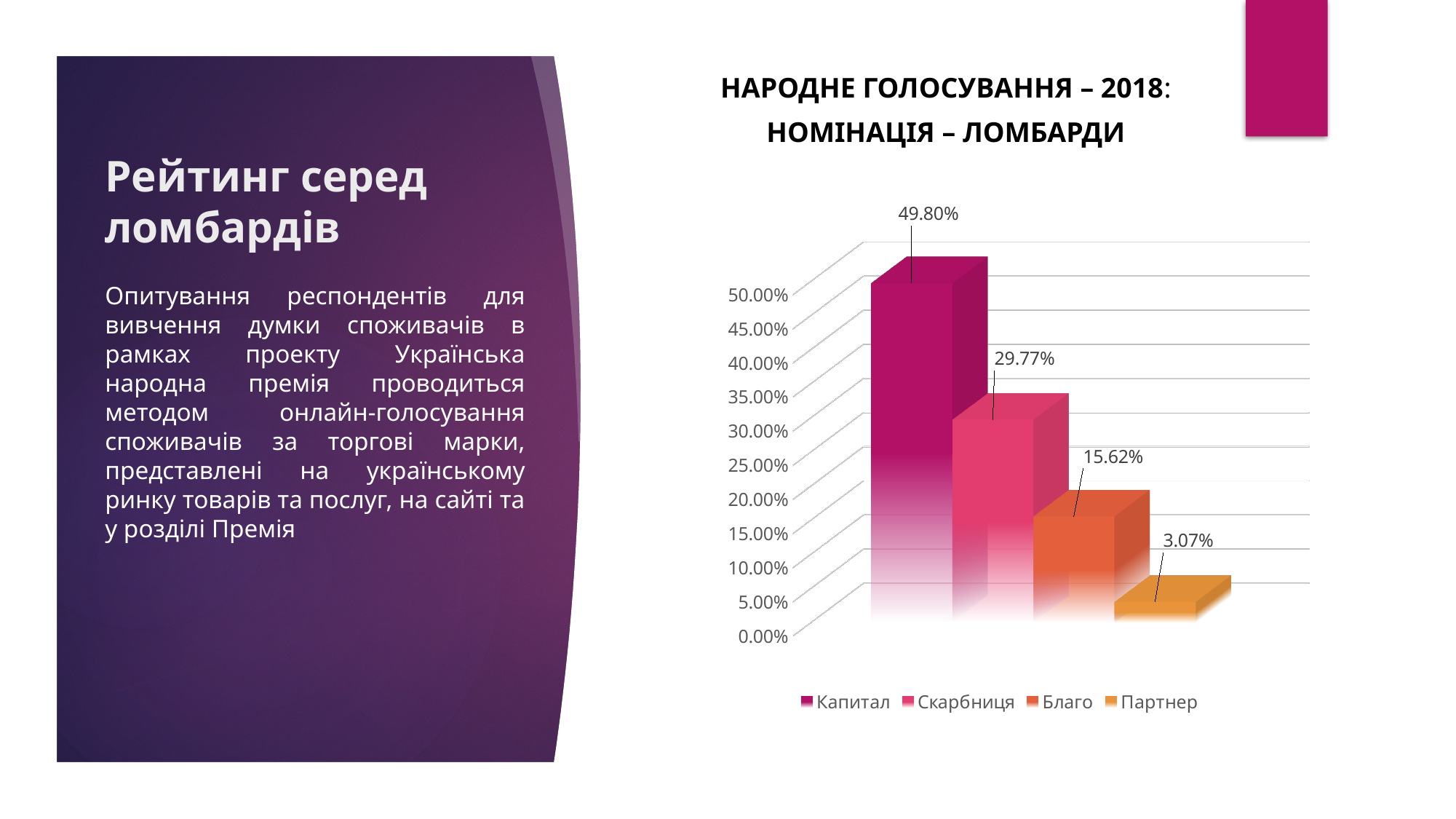
What is the value for Партнер? 3.07% What is the difference between the values for Благо and Партнер? 12.55% What is the value for Благо? 15.62% What is the title of the chart? НАРОДНЕ ГОЛОСУВАННЯ – 2018: НОМІНАЦІЯ – ЛОМБАРДИ Which series has the lowest value? Партнер Which series has the highest value? Капитал What is the value for Скарбниця? 29.77% How many series does the legend list? 4 Which is larger, the value for Скарбниця or the value for Благо? Скарбниця What is the difference between the values for Капитал and Скарбниця? 20.03% What kind of chart is shown on the slide? Bar chart What is the value for Капитал? 49.80%